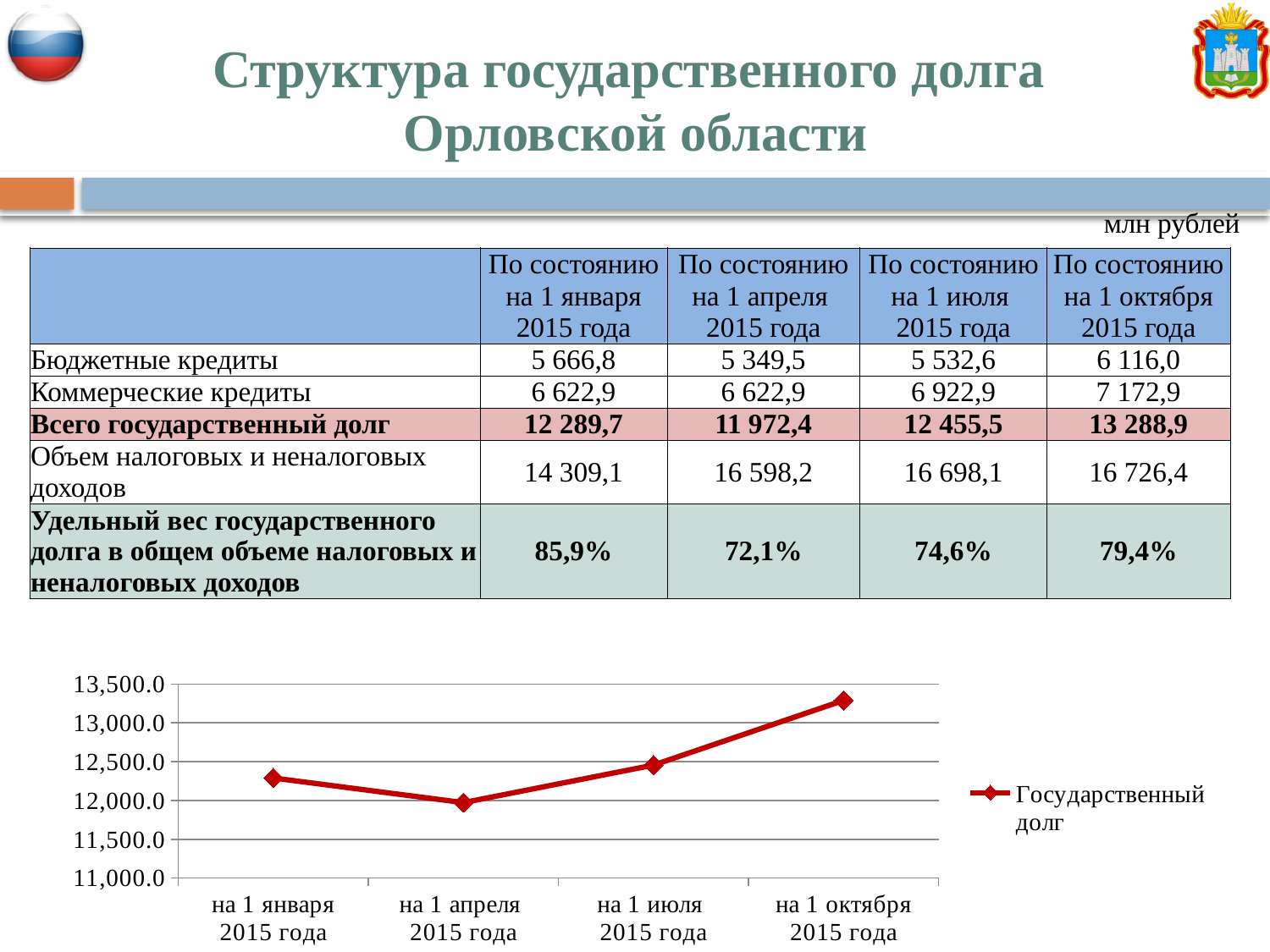
On the line chart, which is larger: the value for на 1 января 2015 года or the value for на 1 апреля 2015 года? на 1 января 2015 года How many data points are plotted on the line chart? 4 What is the name of the series shown in the legend of the line chart? Государственный долг How many series does the legend of the line chart list? 1 On the line chart, is the value for на 1 октября 2015 года greater or less than 13,000.0? greater What is the highest value shown on the vertical axis of the line chart? 13,500.0 What kind of chart is shown at the bottom of the slide? line chart On the line chart, is the value for на 1 января 2015 года greater or less than 12,500.0? less On the line chart, which date has the highest value? на 1 октября 2015 года On the line chart, do the values rise or fall from на 1 апреля 2015 года to на 1 октября 2015 года? rise On the line chart, which date has the lowest value? на 1 апреля 2015 года On the line chart, is the value for на 1 июля 2015 года greater or less than 12,000.0? greater